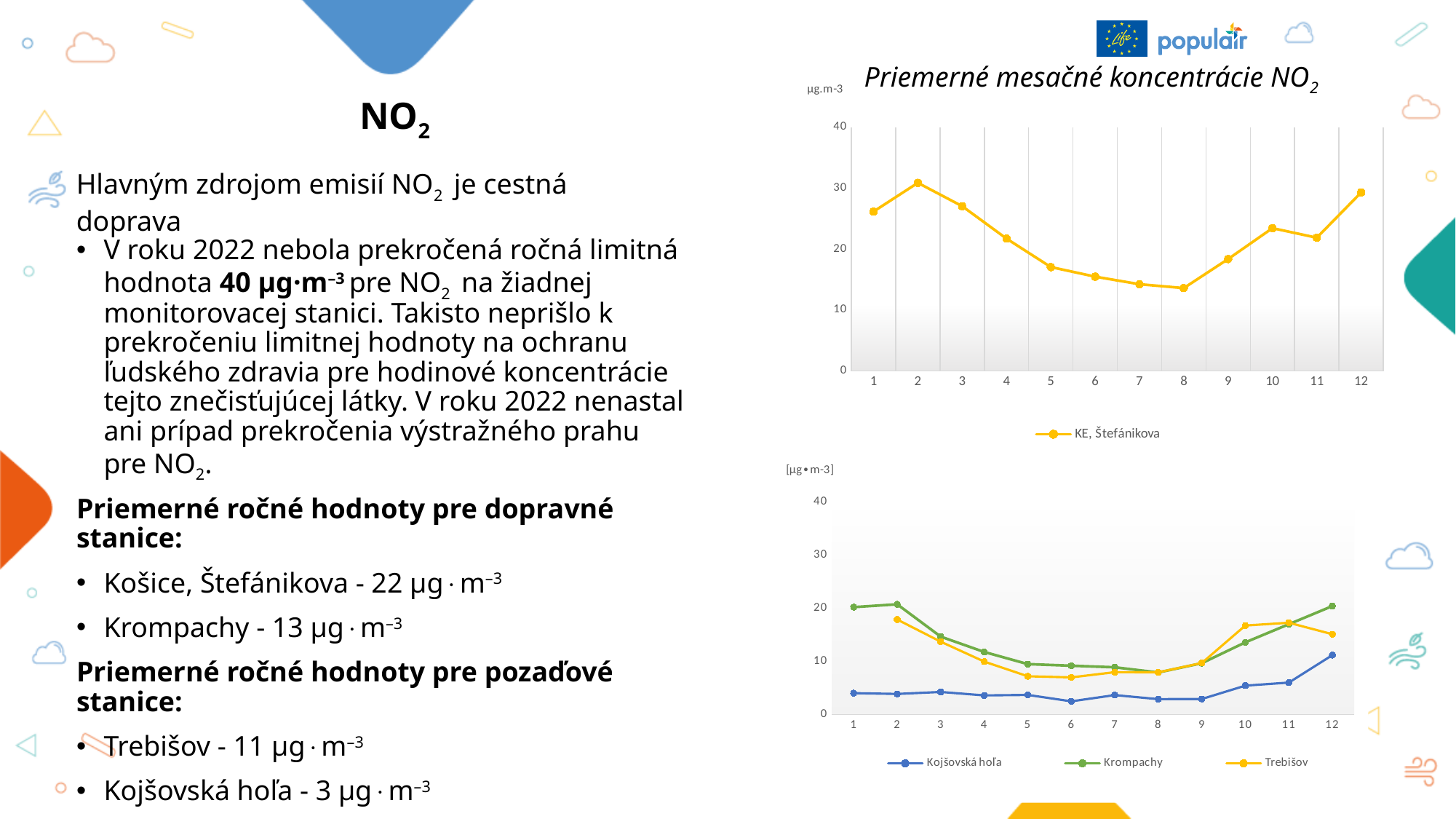
In the bottom chart, which series has the lowest value in month 1? Kojšovská hoľa How many series does the legend of the bottom chart list? 3 In the bottom chart, do the Kojšovská hoľa values rise or fall from month 9 to month 12? rise In the top chart 'Priemerné mesačné koncentrácie NO2', in which month is the KE, Štefánikova value highest? 2 In the bottom chart, is the value for Trebišov in month 10 greater or less than 10? greater In the top chart 'Priemerné mesačné koncentrácie NO2', is the value for month 1 greater or less than 20? greater In the top chart 'Priemerné mesačné koncentrácie NO2', which series does the legend list? KE, Štefánikova In the top chart 'Priemerné mesačné koncentrácie NO2', do the values rise or fall from month 2 to month 8? fall What kind of chart is the top chart titled 'Priemerné mesačné koncentrácie NO2'? line chart In the top chart 'Priemerné mesačné koncentrácie NO2', in which month is the KE, Štefánikova value lowest? 8 In the top chart 'Priemerné mesačné koncentrácie NO2', is the value for month 8 greater or less than 20? less In the top chart 'Priemerné mesačné koncentrácie NO2', how many months are plotted on the x axis? 12